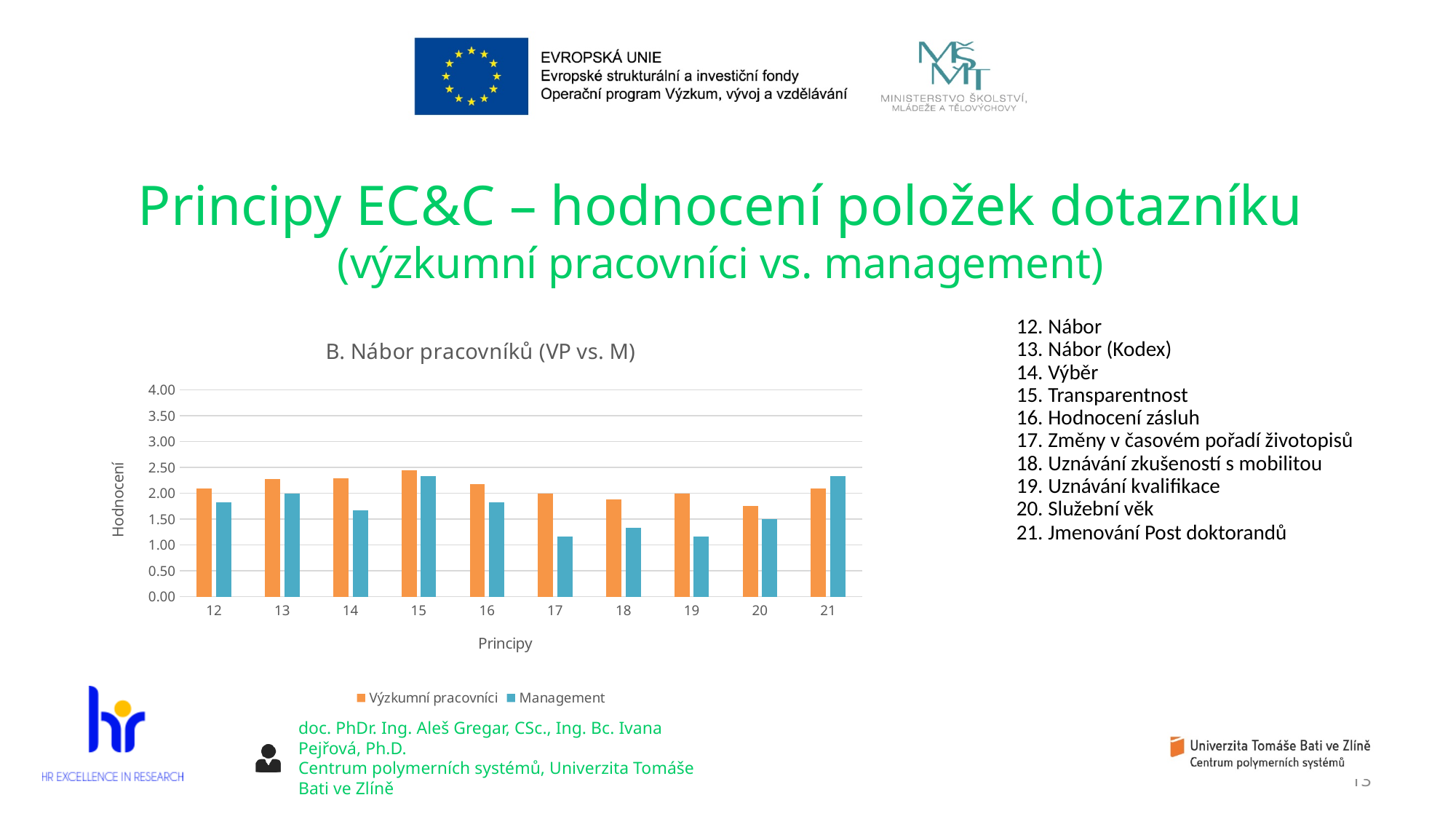
Is the Management value for principle 17 greater or less than 1.50? less Is the Management value for principle 21 greater or less than 2.00? greater What is the label of the vertical axis of the chart? Hodnocení Is the Výzkumní pracovníci value for principle 15 greater or less than 2.00? greater Which principle has the lowest value for Výzkumní pracovníci? 20 How many series does the chart legend list? 2 What is the title of the chart? B. Nábor pracovníků (VP vs. M) How many principle categories are shown on the x axis of the chart? 10 For principle 21, which series has the larger value, Výzkumní pracovníci or Management? Management For principle 19, which series has the larger value, Výzkumní pracovníci or Management? Výzkumní pracovníci What kind of chart is shown on the slide? bar chart Which principle has the highest value for Výzkumní pracovníci? 15